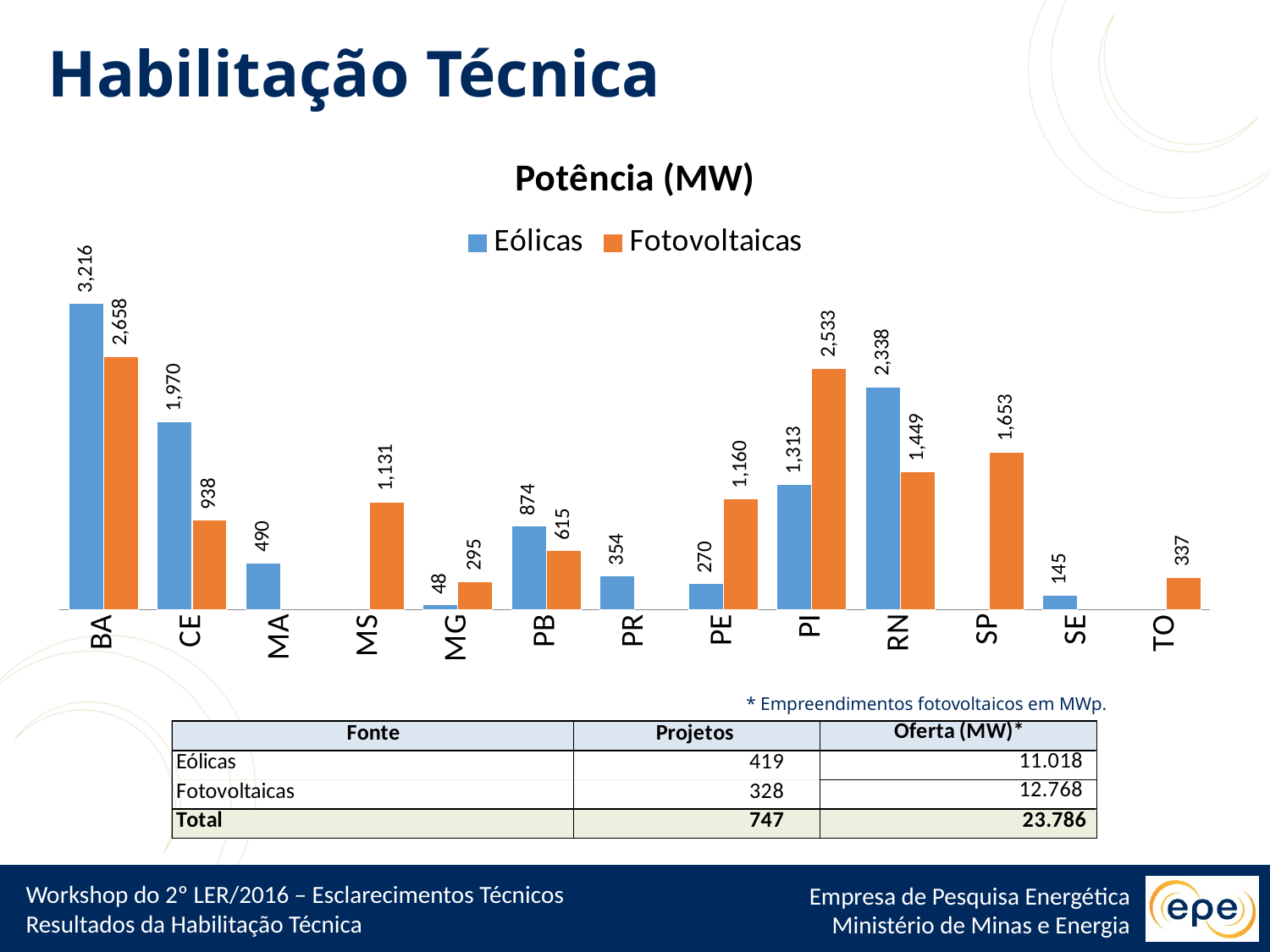
What kind of chart is shown? Bar chart How many series does the legend list? 2 Which state has the lowest Fotovoltaicas value among those with a Fotovoltaicas bar? MG What is the Fotovoltaicas value for PI? 2,533 Which state has the highest Eólicas value? BA For PE, which is larger, Eólicas or Fotovoltaicas? Fotovoltaicas How many states are shown on the x axis? 13 What is the Fotovoltaicas value for SP? 1,653 What is the Eólicas value for BA? 3,216 What is the difference between the Eólicas and Fotovoltaicas values for BA? 558 What is the Eólicas value for MG? 48 What is the title of the chart? Potência (MW)